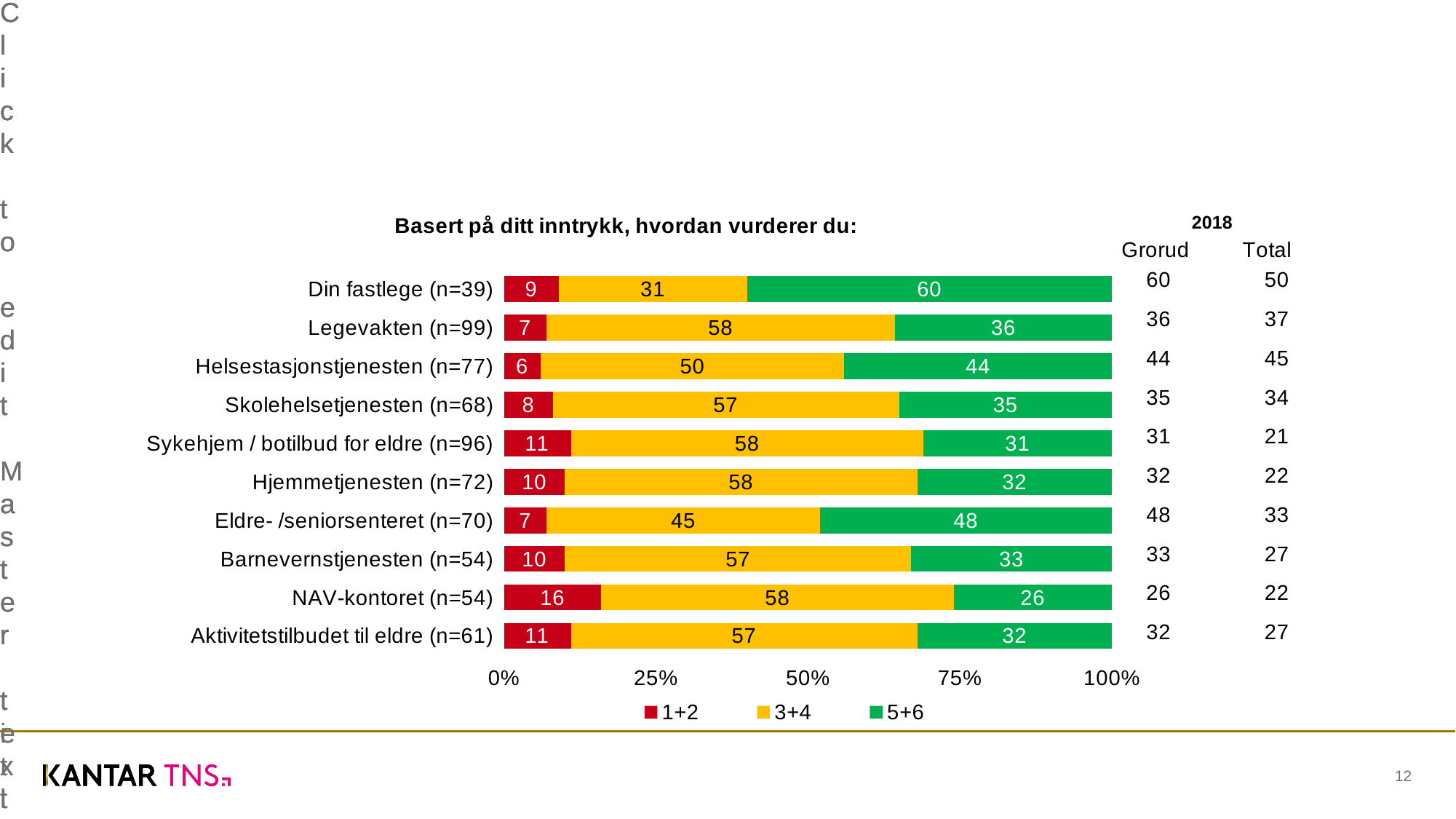
Which has the larger 5+6 value, Eldre- /seniorsenteret (n=70) or Helsestasjonstjenesten (n=77)? Eldre- /seniorsenteret (n=70) What is the value of the 5+6 series for Din fastlege (n=39)? 60 What is the title of the chart? Basert på ditt inntrykk, hvordan vurderer du: What is the value of the 1+2 series for NAV-kontoret (n=54)? 16 What is the difference between the 5+6 values for Din fastlege (n=39) and NAV-kontoret (n=54)? 34 Which category has the highest value in the 5+6 series? Din fastlege (n=39) What is the value of the 3+4 series for Legevakten (n=99)? 58 How many categories are shown in the chart? 10 Which category has the lowest value in the 5+6 series? NAV-kontoret (n=54) What kind of chart is shown on the slide? Stacked bar chart Which category has the lowest value in the 1+2 series? Helsestasjonstjenesten (n=77) How many series does the legend list? 3